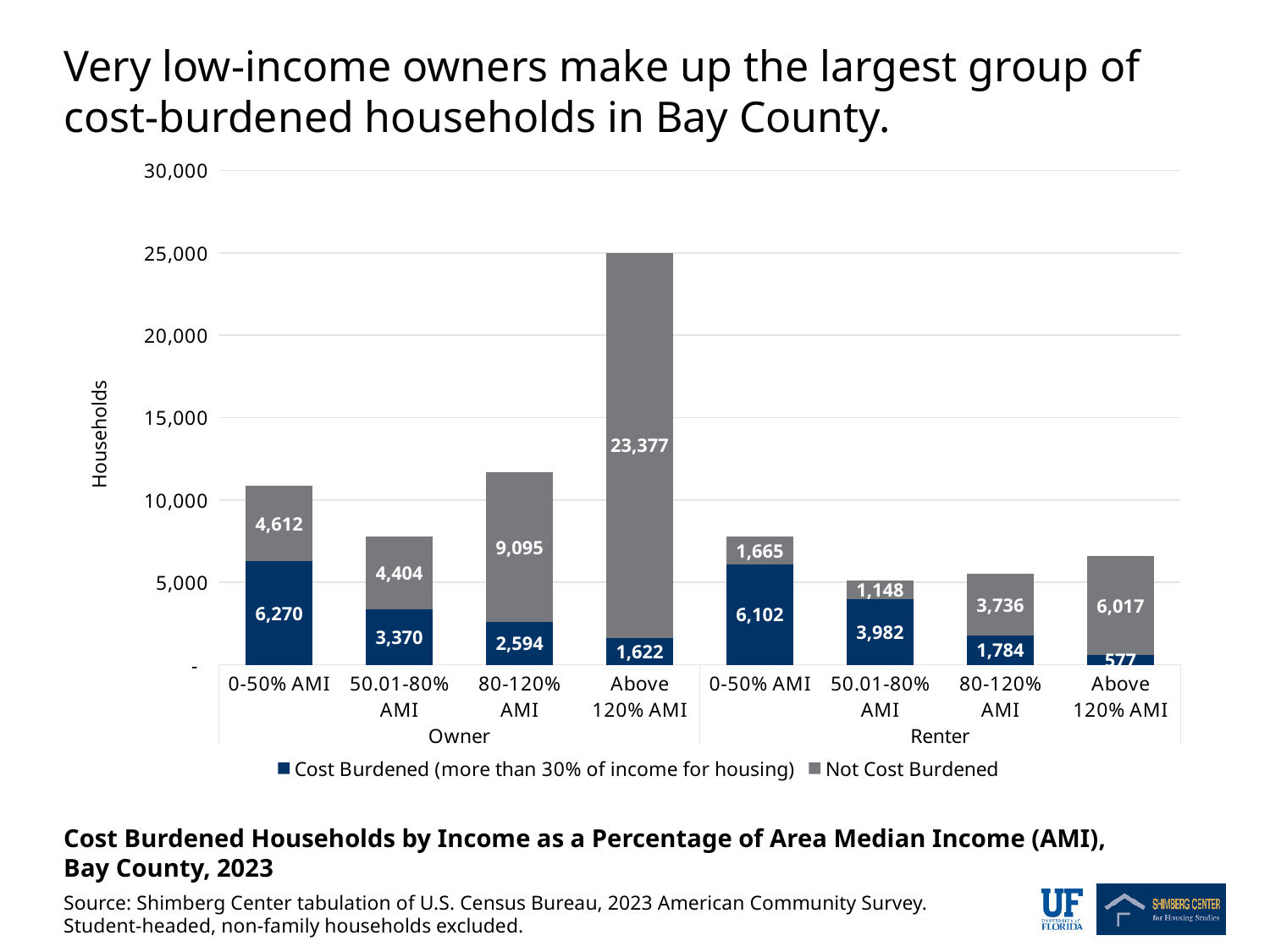
How many income groups (bars) are shown in the chart? 8 What type of chart is shown on the slide? Stacked bar chart How many not-cost-burdened owner households are in the Above 120% AMI group? 23,377 What is the difference between cost-burdened owner households and cost-burdened renter households in the 0-50% AMI group? 168 How many series does the legend list? 2 Is the total height of the Owner Above 120% AMI bar greater or less than 20,000? greater Which is larger: the number of not-cost-burdened renter households at 80-120% AMI or at Above 120% AMI? Above 120% AMI How many cost-burdened renter households are in the Above 120% AMI group? 577 How many cost-burdened owner households are in the 0-50% AMI group? 6,270 Which group has the highest number of cost-burdened households? Owner, 0-50% AMI What is the total number of renter households in the 0-50% AMI group (cost burdened plus not cost burdened)? 7,767 Which group has the lowest number of cost-burdened households? Renter, Above 120% AMI